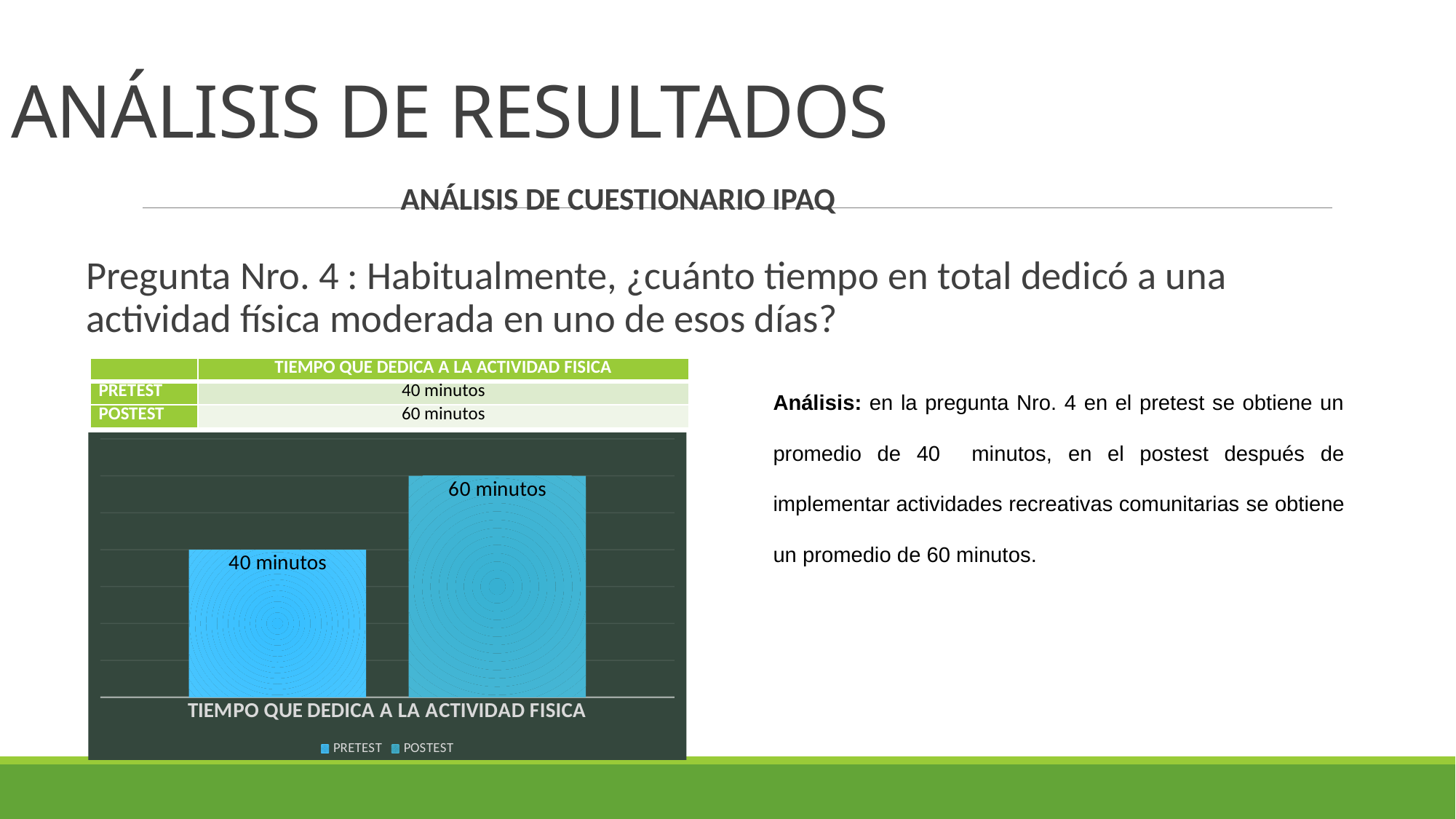
Which series has the higher value, PRETEST or POSTEST? POSTEST What is the value for PRETEST in the chart? 40 minutos How many bars are plotted in the chart? 2 What is the value for POSTEST in the chart? 60 minutos What kind of chart is shown on the slide? bar chart What is the category label shown below the bars? TIEMPO QUE DEDICA A LA ACTIVIDAD FISICA Which series has the lower value in the chart? PRETEST What is the difference between the POSTEST and PRETEST values? 20 minutos Is the PRETEST value larger or smaller than the POSTEST value? smaller How many series does the legend list? 2 What are the two legend entries of the chart? PRETEST and POSTEST